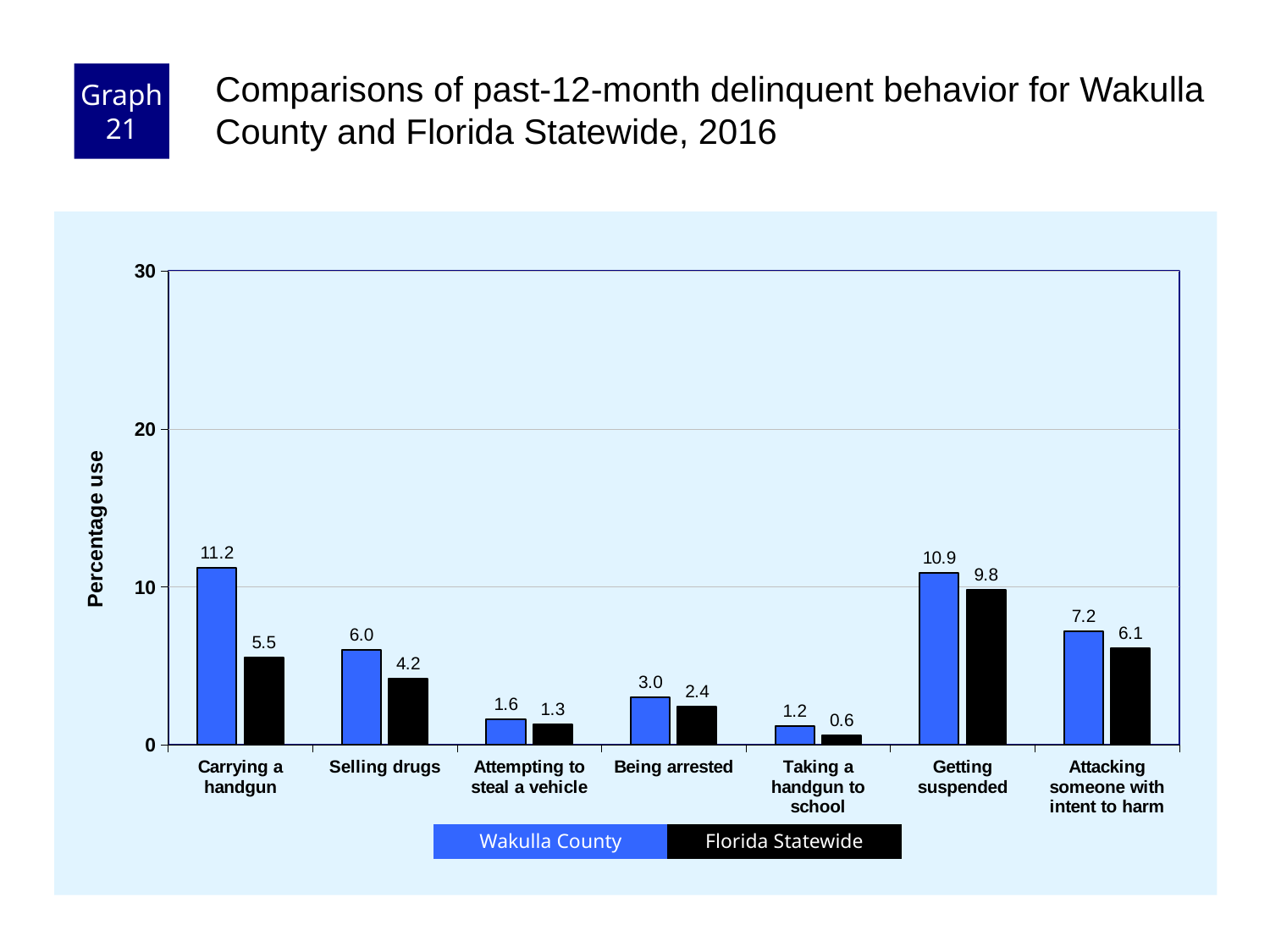
Which is larger for Attacking someone with intent to harm: Wakulla County or Florida Statewide? Wakulla County What kind of chart is shown on the slide? Bar chart What is the Wakulla County value for Taking a handgun to school? 1.2 Which category has the highest Wakulla County value? Carrying a handgun What is the difference between the Wakulla County and Florida Statewide values for Carrying a handgun? 5.7 How many categories are shown on the x axis? 7 Is the Wakulla County value for Getting suspended greater or less than 10? greater Which category has the lowest Florida Statewide value? Taking a handgun to school How many series does the legend list? 2 What is the Florida Statewide value for Getting suspended? 9.8 What is the Wakulla County value for Carrying a handgun? 11.2 What is the difference between the Wakulla County and Florida Statewide values for Selling drugs? 1.8